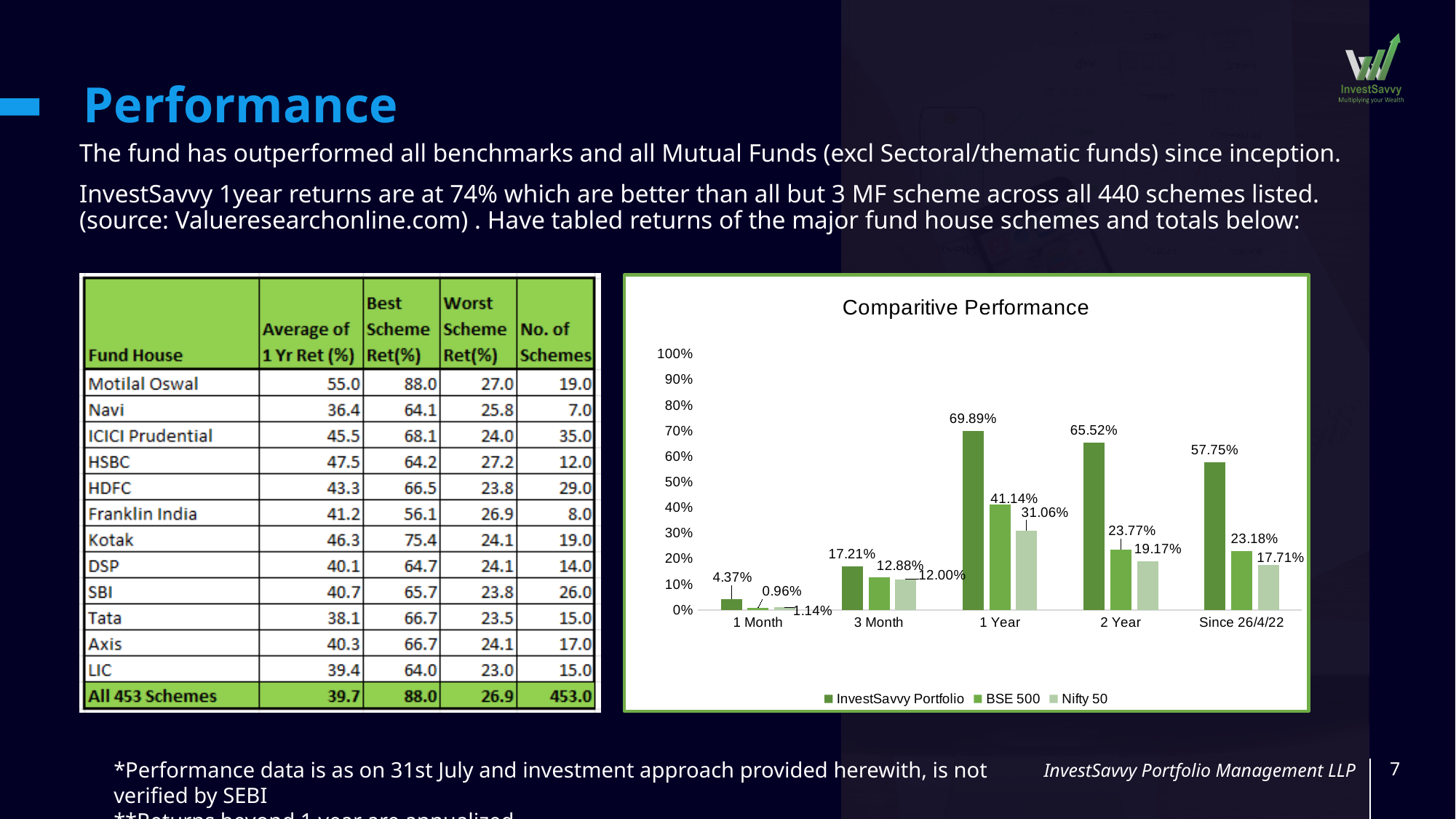
For 1 Month in the Comparitive Performance chart, which is larger: BSE 500 or Nifty 50? Nifty 50 What is the InvestSavvy Portfolio value for 1 Year in the Comparitive Performance chart? 69.89% What is the title of the chart on the slide? Comparitive Performance What type of chart is the Comparitive Performance chart? bar chart How many time-period categories are shown on the x axis of the Comparitive Performance chart? 5 Is the InvestSavvy Portfolio value for 2 Year greater or less than 60% in the Comparitive Performance chart? greater What is the BSE 500 value for Since 26/4/22 in the Comparitive Performance chart? 23.18% What is the Nifty 50 value for 2 Year in the Comparitive Performance chart? 19.17% What is the difference between the InvestSavvy Portfolio and BSE 500 values for 1 Year in the Comparitive Performance chart? 28.75% Which period has the highest InvestSavvy Portfolio value in the Comparitive Performance chart? 1 Year Which period has the lowest BSE 500 value in the Comparitive Performance chart? 1 Month How many series does the legend of the Comparitive Performance chart list? 3